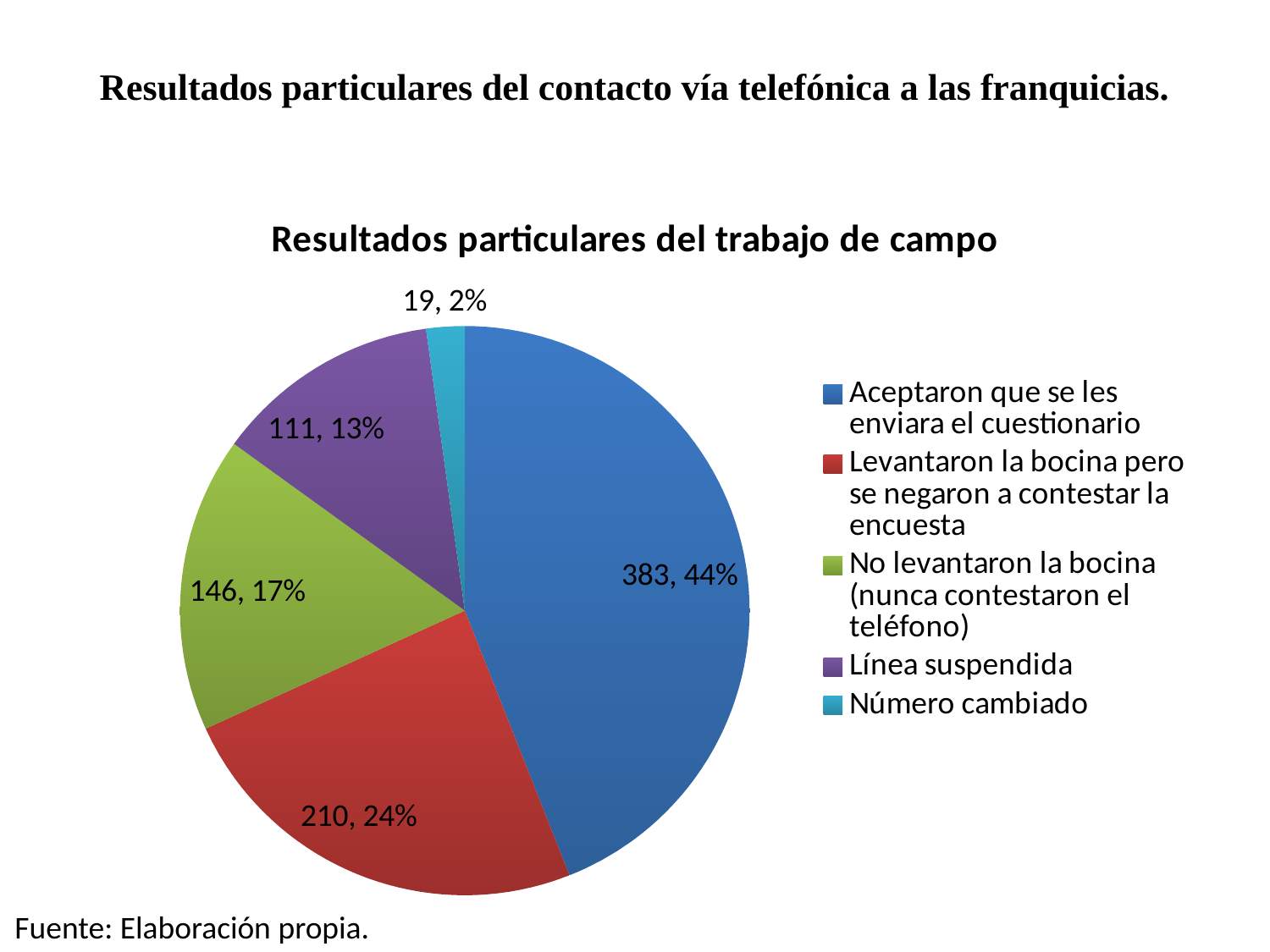
What is the value for 'Aceptaron que se les enviara el cuestionario'? 383 What is the title of the chart? Resultados particulares del trabajo de campo Which category has the largest slice? Aceptaron que se les enviara el cuestionario How many entries does the legend list? 5 What is the value for 'Número cambiado'? 19 How many slices does the pie chart have? 5 What is the difference between the values for 'Aceptaron que se les enviara el cuestionario' and 'Levantaron la bocina pero se negaron a contestar la encuesta'? 173 What type of chart is shown on the slide? Pie chart What share of the pie does 'No levantaron la bocina (nunca contestaron el teléfono)' represent? 17% Which category has the smallest slice? Número cambiado What share of the pie does 'Levantaron la bocina pero se negaron a contestar la encuesta' represent? 24% What is the value for 'Línea suspendida'? 111